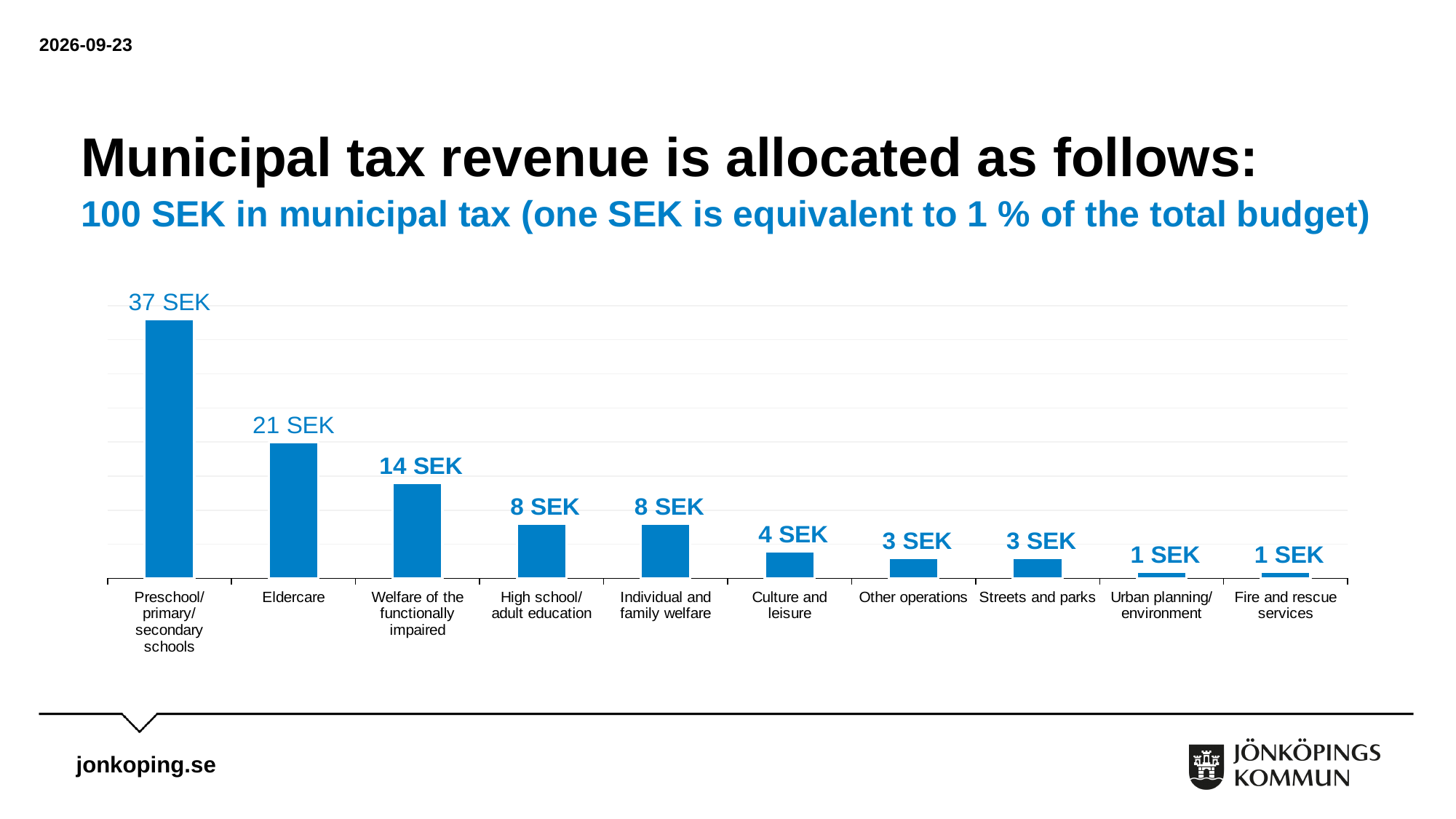
What is the combined allocation for Urban planning/environment and Fire and rescue services? 2 SEK What is the value for Streets and parks? 3 SEK How many categories are shown in the chart? 10 Do the values rise or fall from left to right along the x axis? Fall What is the value for Welfare of the functionally impaired? 14 SEK How many SEK go to Culture and leisure? 4 SEK What is the difference between the allocation for Preschool/primary/secondary schools and Eldercare? 16 SEK How many SEK are allocated to Eldercare? 21 SEK What kind of chart is shown on the slide? Bar chart What is the title of the slide containing the chart? Municipal tax revenue is allocated as follows: Which is larger, the allocation for High school/adult education or for Other operations? High school/adult education Which category receives the largest allocation? Preschool/primary/secondary schools